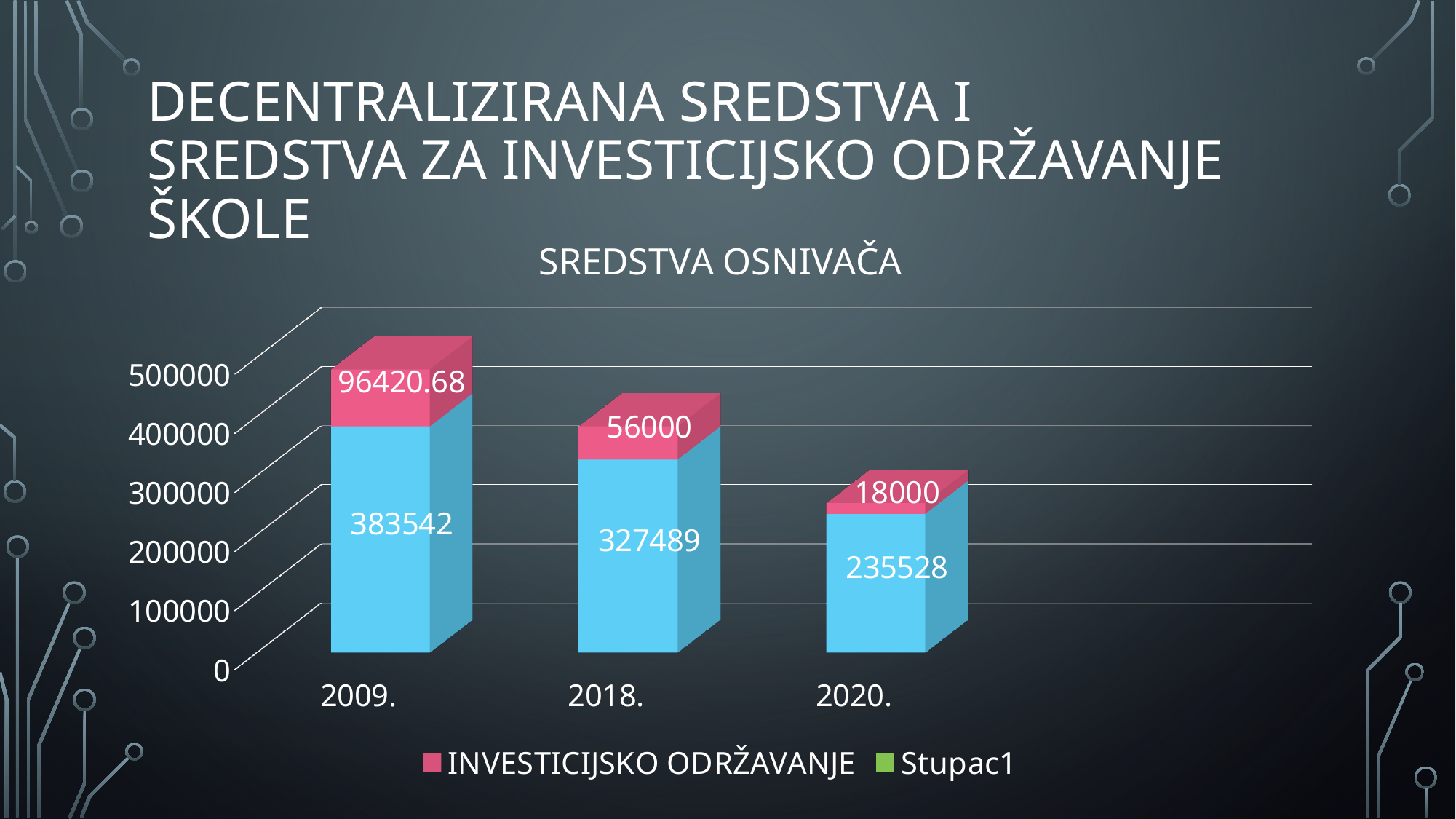
Which year has the lowest blue segment value? 2020. What is the total of the stacked bar for 2018.? 383489 Which year has the highest INVESTICIJSKO ODRŽAVANJE value? 2009. What is the value of INVESTICIJSKO ODRŽAVANJE for 2009.? 96420.68 What is the difference between the INVESTICIJSKO ODRŽAVANJE values for 2018. and 2020.? 38000 Do the INVESTICIJSKO ODRŽAVANJE values rise or fall from 2009. to 2020.? fall What is the value of INVESTICIJSKO ODRŽAVANJE for 2020.? 18000 How many series does the legend list? 2 Is the blue segment larger for 2018. or for 2020.? 2018. What is the value of the blue segment for 2018.? 327489 What kind of chart is shown? stacked bar chart How many years are shown on the x axis? 3